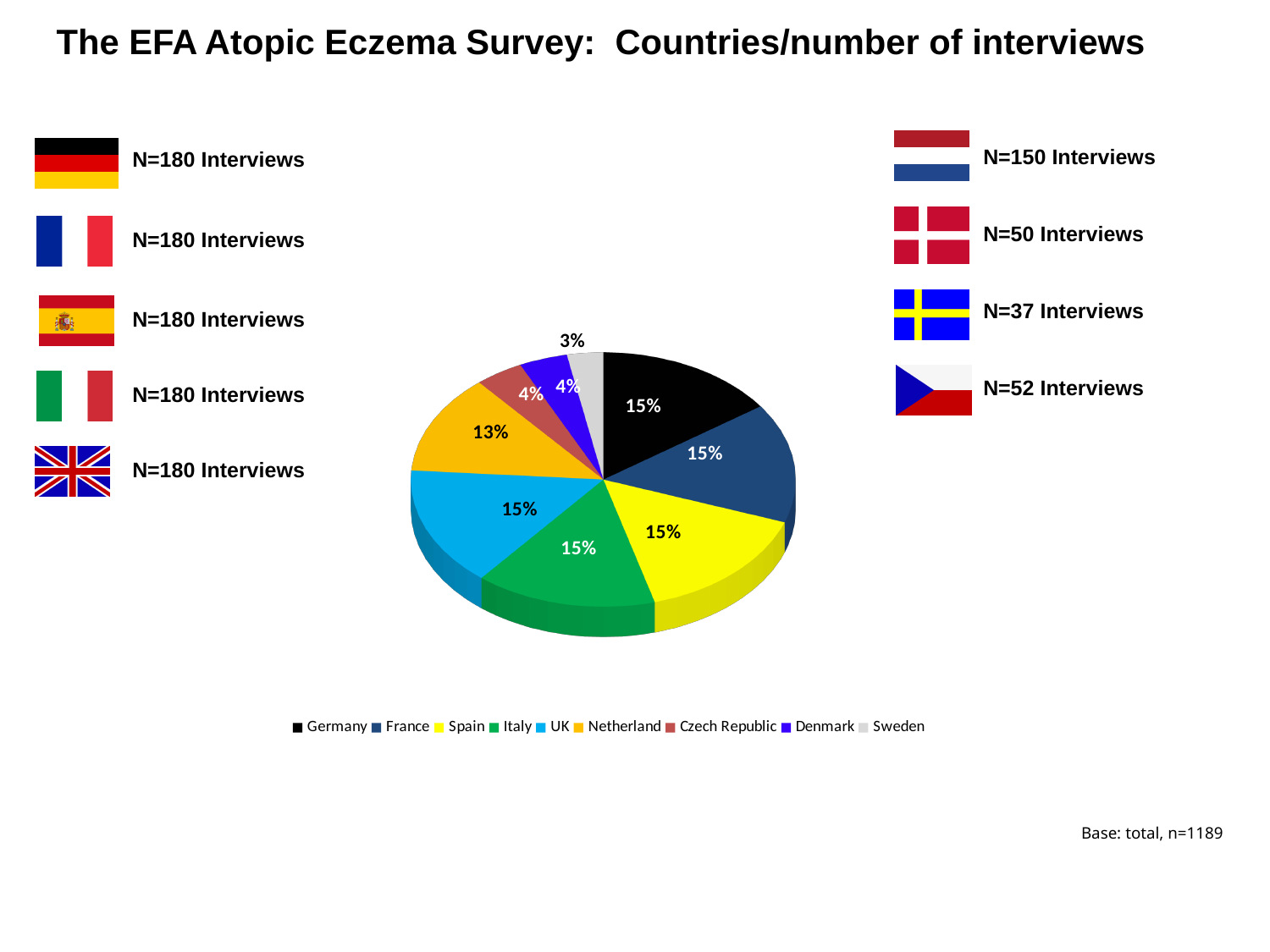
What share of the pie does Netherland account for? 13% Which has the larger share of the pie, Netherland or Czech Republic? Netherland Which country has the smallest slice of the pie? Sweden What share of the pie does Denmark account for? 4% How many countries are shown as slices in the pie chart? 9 What share of the pie does Germany account for? 15% Which country is shown in black in the pie chart legend? Germany What share of the pie does Sweden account for? 3% By how many percentage points does Netherland's share exceed Sweden's share? 10 percentage points What kind of chart is shown on the slide? Pie chart Which has the larger share of the pie, UK or Sweden? UK What share of the pie does Czech Republic account for? 4%